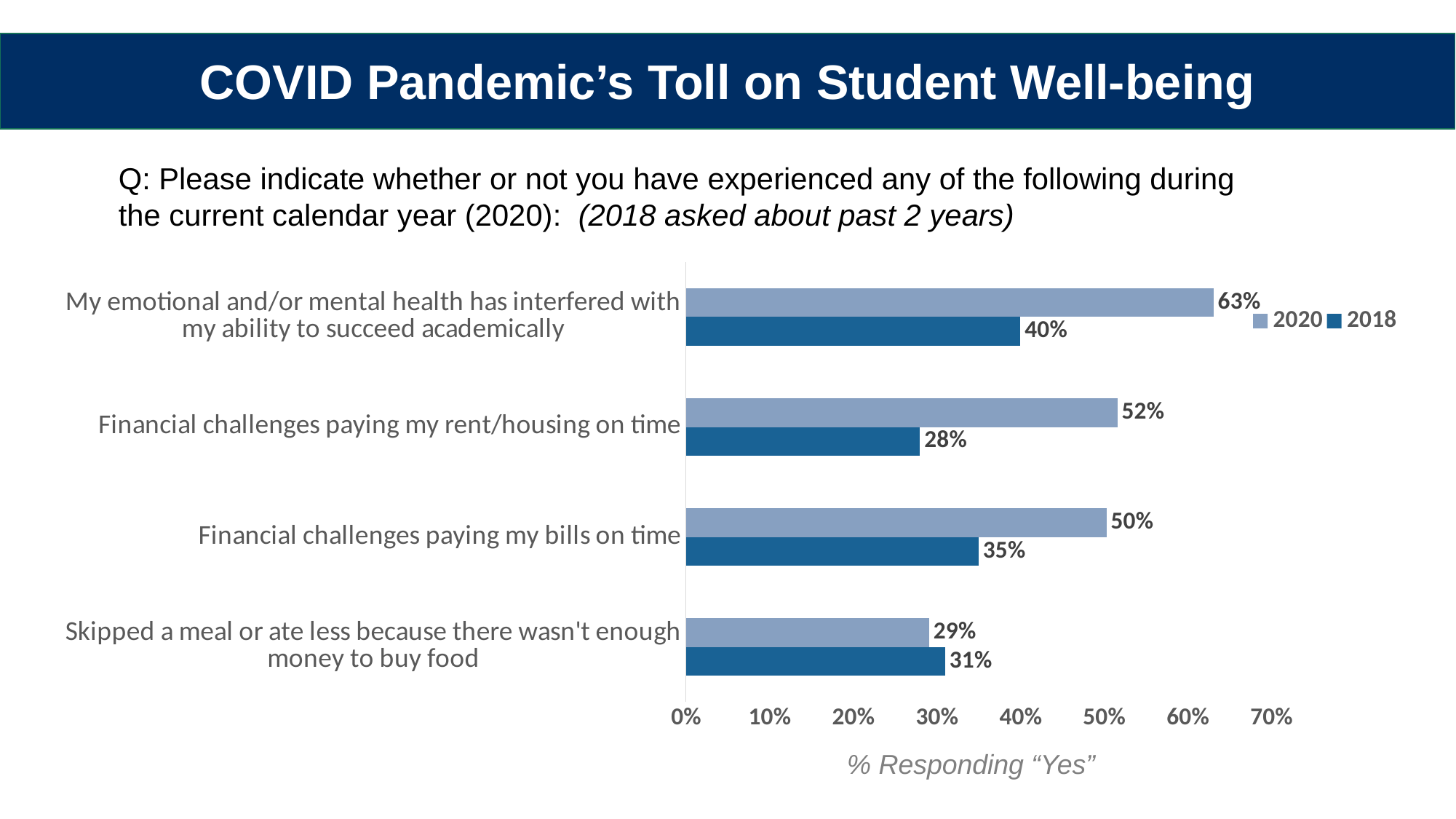
How many categories are shown on the chart? 4 How many series does the legend list? 2 Which series is shown in the darker blue colour? 2018 What is the x-axis label of the chart? % Responding "Yes" What was the 2018 value for 'Financial challenges paying my rent/housing on time'? 28% What kind of chart is shown on the slide? Bar chart What is the difference between the 2020 and 2018 values for 'Financial challenges paying my bills on time'? 15% What percentage responded 'Yes' in 2020 to 'Skipped a meal or ate less because there wasn't enough money to buy food'? 29% Which category has the lowest 2018 value? Financial challenges paying my rent/housing on time For 'Skipped a meal or ate less because there wasn't enough money to buy food', which year has the larger value, 2020 or 2018? 2018 What percentage of students in 2020 said their emotional and/or mental health interfered with their ability to succeed academically? 63% Which category has the highest 2020 value? My emotional and/or mental health has interfered with my ability to succeed academically